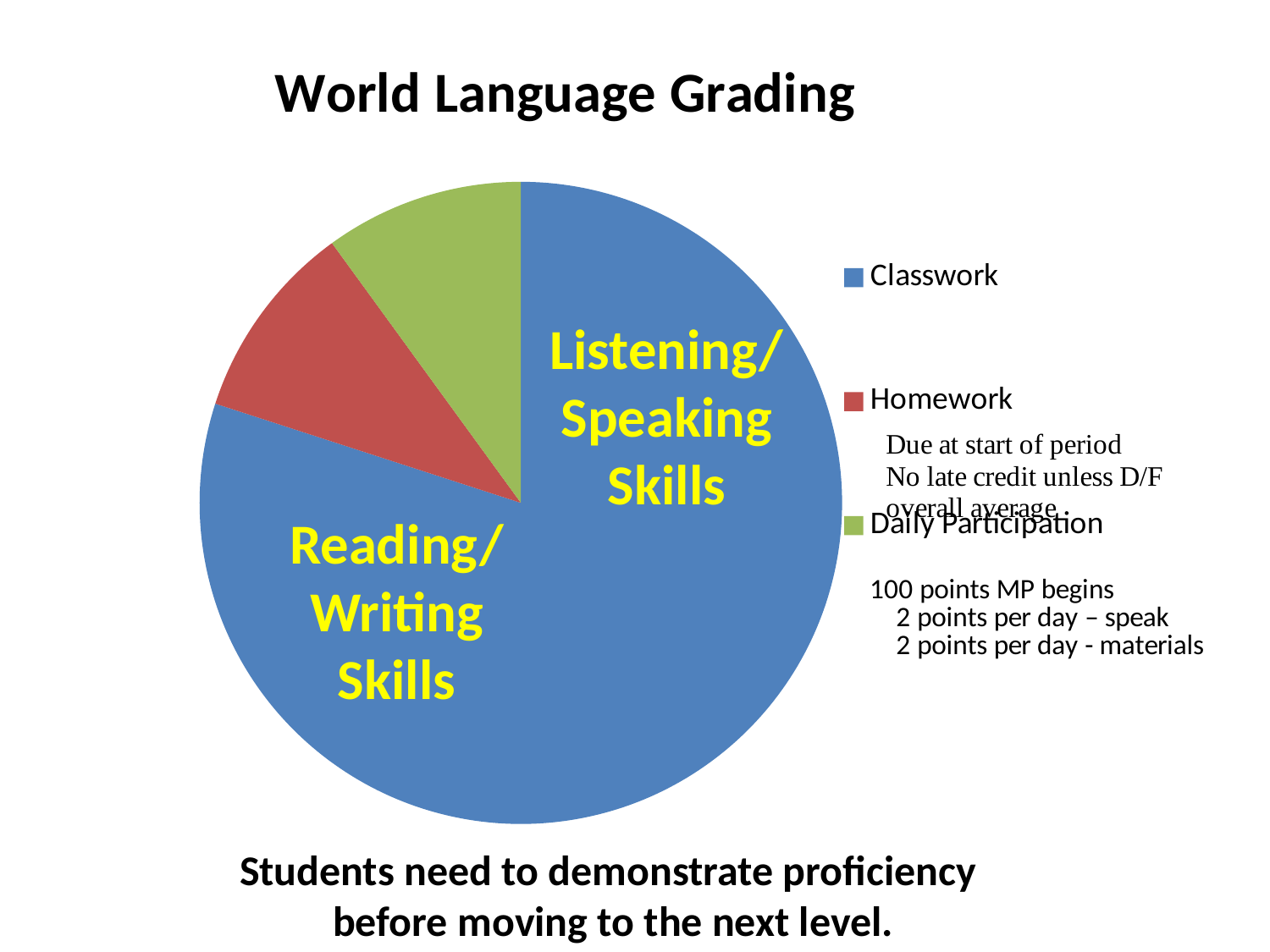
How many slices does the pie chart have? 3 Does the Classwork slice make up more or less than half of the pie? more What colour is the Classwork slice in the pie chart? blue What is the title of the chart? World Language Grading Which is larger, the Classwork slice or the Homework slice? Classwork What kind of chart is shown on the slide? pie chart How many entries does the legend list? 3 Which is larger, the Classwork slice or the Daily Participation slice? Classwork Which category has the largest slice of the pie? Classwork